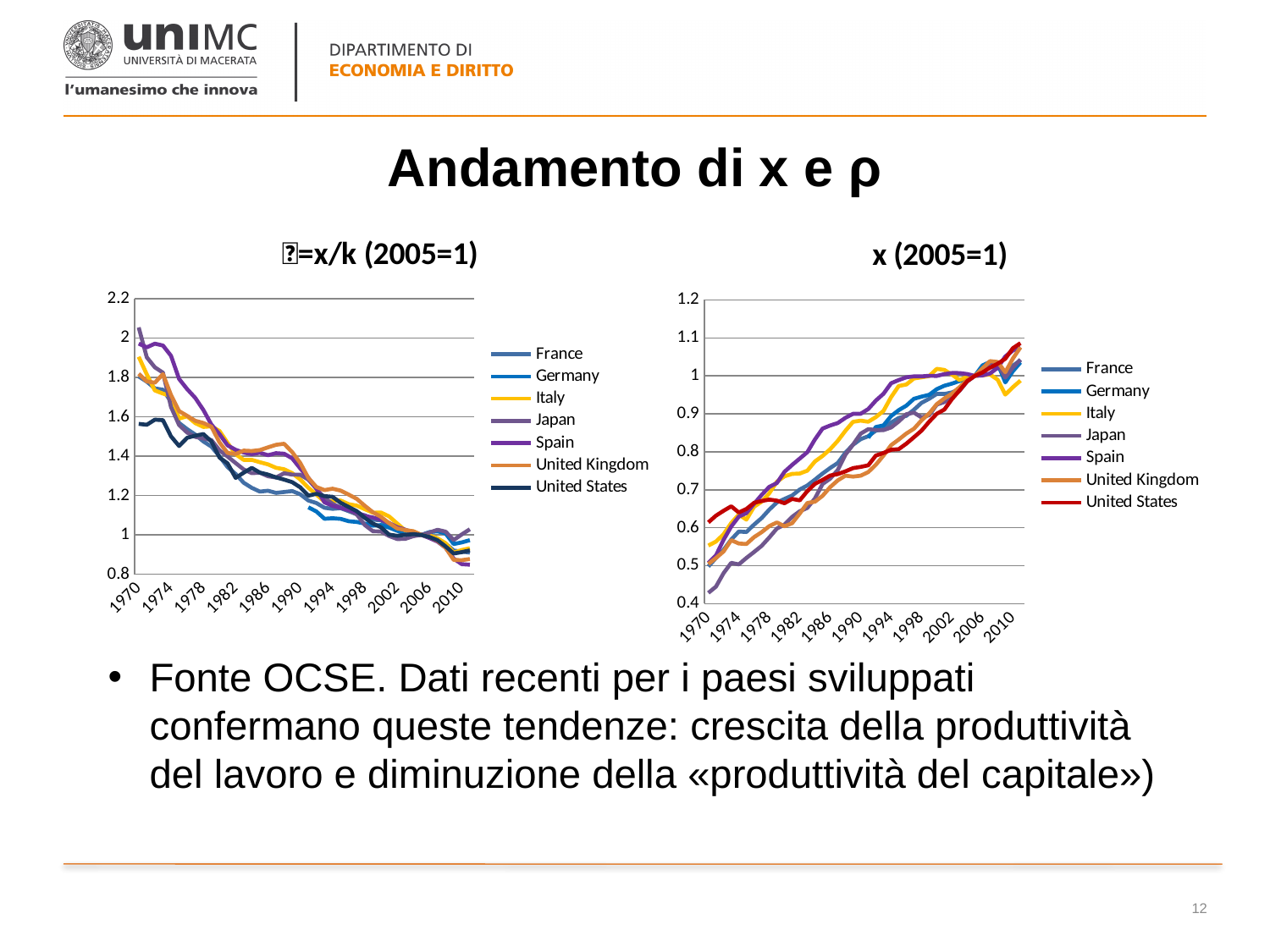
Which country is listed last in the legend of the right chart "x (2005=1)"? United States What is the title of the chart on the right of the slide? x (2005=1) How many series does the legend of the left chart "=x/k (2005=1)" list? 7 In the right chart "x (2005=1)", is the value for Spain in 2010 greater or less than 1? greater In the left chart "=x/k (2005=1)", is the value for United Kingdom in 2010 greater or less than 1? less How many series does the legend of the right chart "x (2005=1)" list? 7 In the left chart "=x/k (2005=1)", is the value for United States in 1970 greater or less than 1.4? greater In the right chart "x (2005=1)", do the values generally rise or fall from 1970 to 2010? rise In the left chart "=x/k (2005=1)", do the values generally rise or fall from 1970 to 2010? fall What kind of chart is the left chart titled "=x/k (2005=1)"? line chart What kind of chart is the chart titled "x (2005=1)" on the right of the slide? line chart